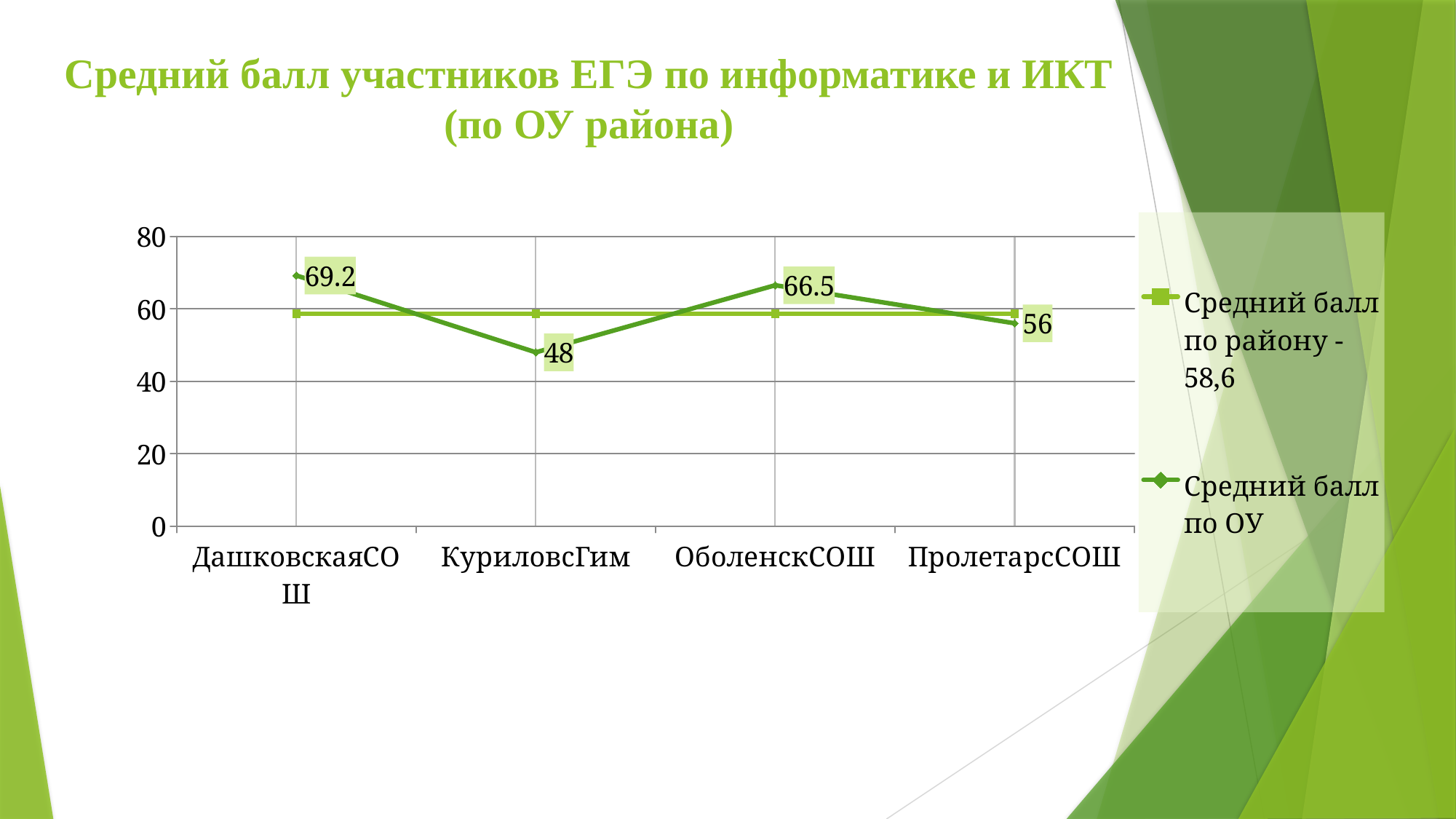
What is the average score (Средний балл по ОУ) for ОболенскСОШ? 66.5 How many series does the legend list? 2 What type of chart is shown on the slide? line chart How many schools are shown on the x axis of the chart? 4 What is the difference between the average scores of ДашковскаяСОШ and КуриловсГим? 21.2 Which has a higher average score, ОболенскСОШ or ПролетарсСОШ? ОболенскСОШ Which school has the lowest average score in the Средний балл по ОУ series? КуриловсГим What is the average score (Средний балл по ОУ) for ПролетарсСОШ? 56 What is the average score (Средний балл по ОУ) for КуриловсГим? 48 What is the average score (Средний балл по ОУ) for ДашковскаяСОШ? 69.2 Is the average score for ПролетарсСОШ greater or less than 60? less Which school has the highest average score in the Средний балл по ОУ series? ДашковскаяСОШ